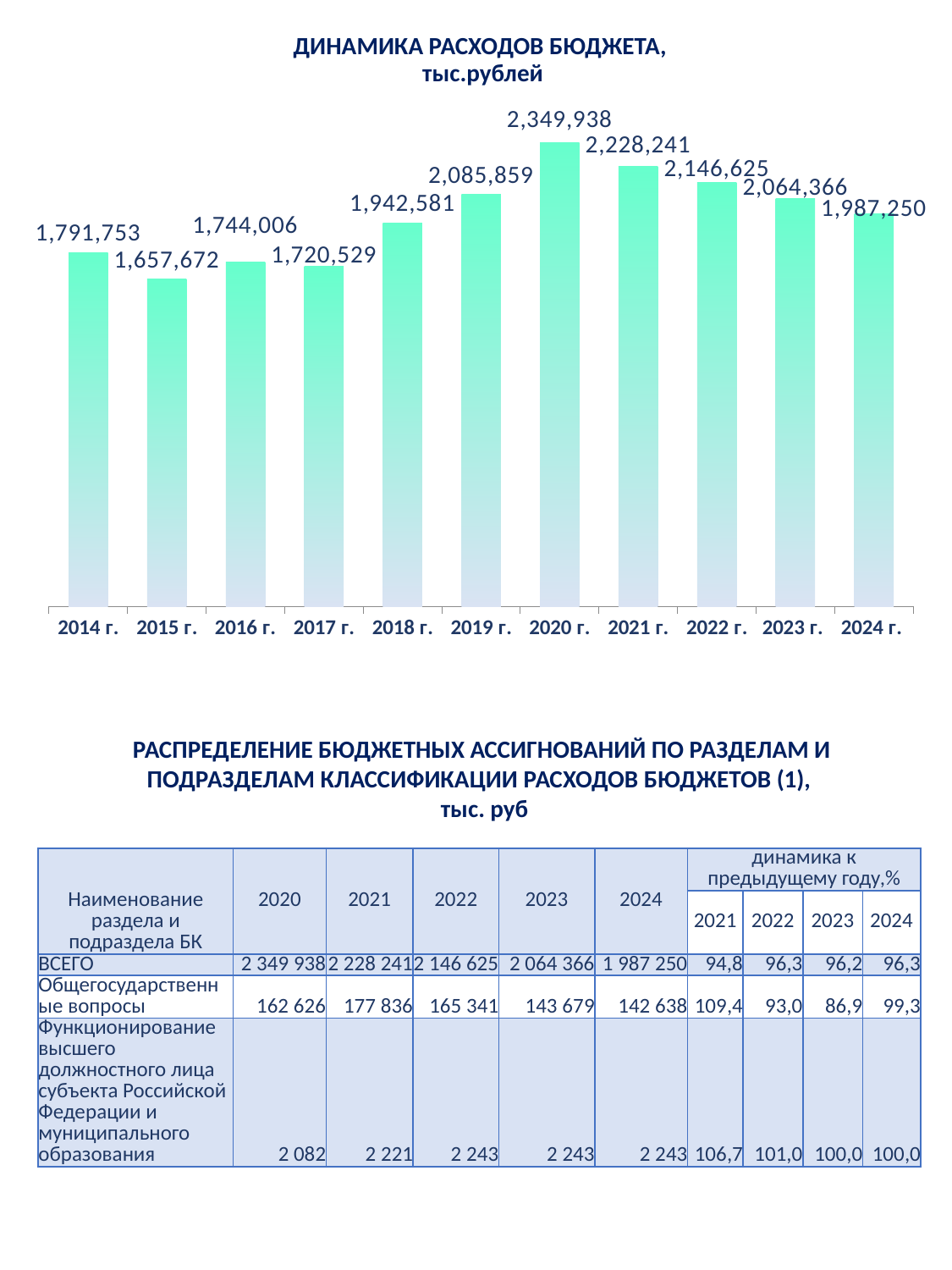
What is the value for 2024 г. in the chart? 1,987,250 What is the value for 2018 г. in the chart? 1,942,581 What is the value for 2020 г. in the chart? 2,349,938 Which is larger, the value for 2016 г. or the value for 2017 г.? 2016 г. How many years are shown on the x axis of the chart? 11 What kind of chart is shown on the slide? bar chart What is the difference between the values for 2020 г. and 2021 г.? 121,697 What is the difference between the values for 2014 г. and 2015 г.? 134,081 Which year has the highest value in the chart? 2020 г. Which year has the lowest value in the chart? 2015 г. What is the value for 2015 г. in the chart? 1,657,672 Do the values rise or fall from 2020 г. to 2024 г.? fall